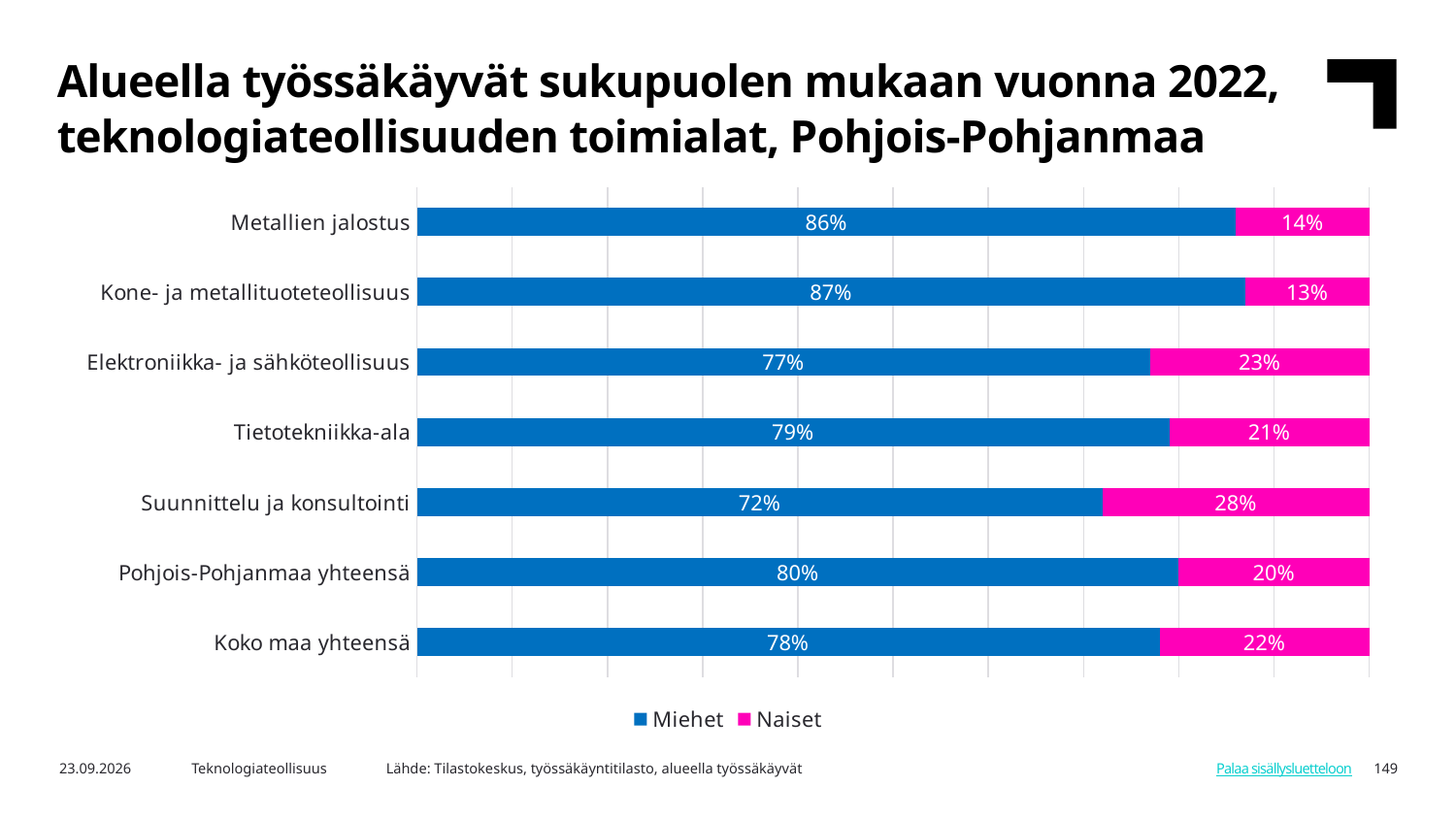
Which colour represents Naiset in the chart? Pink (magenta) What is the Naiset share for Koko maa yhteensä? 22% What is the Miehet share for Metallien jalostus? 86% What is the Naiset share for Suunnittelu ja konsultointi? 28% Which is larger: the Miehet share for Tietotekniikka-ala or for Suunnittelu ja konsultointi? Tietotekniikka-ala What is the total of the stacked bar for Pohjois-Pohjanmaa yhteensä? 100% Which category has the lowest Naiset share? Kone- ja metallituoteteollisuus What kind of chart is shown on the slide? Stacked bar chart How many series does the legend list? 2 How many categories are shown on the chart? 7 What is the difference between the Naiset share for Elektroniikka- ja sähköteollisuus and for Metallien jalostus? 9% Which category has the highest Miehet share? Kone- ja metallituoteteollisuus